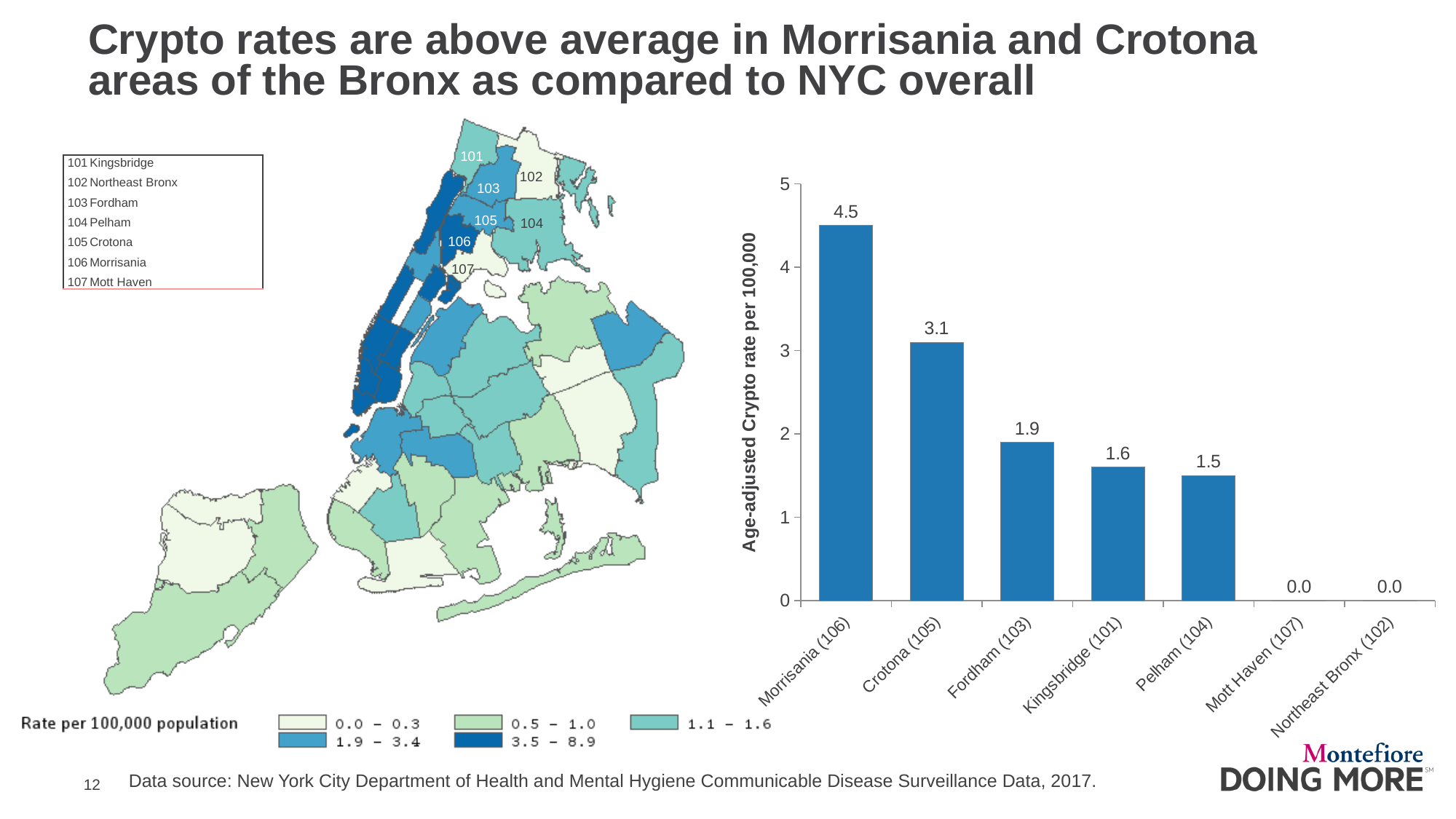
What is the age-adjusted Crypto rate per 100,000 for Pelham (104)? 1.5 What kind of chart is used to show the age-adjusted Crypto rates? Bar chart Which area has the highest age-adjusted Crypto rate in the bar chart? Morrisania (106) Do the values in the bar chart rise or fall from left to right? Fall How many areas are shown on the x axis of the bar chart? 7 What is the Crypto rate shown for Mott Haven (107)? 0.0 What is the age-adjusted Crypto rate per 100,000 for Morrisania (106)? 4.5 What is the label of the y axis of the bar chart? Age-adjusted Crypto rate per 100,000 What is the age-adjusted Crypto rate per 100,000 for Crotona (105)? 3.1 Which has a higher Crypto rate, Kingsbridge (101) or Pelham (104)? Kingsbridge (101) What is the age-adjusted Crypto rate per 100,000 for Fordham (103)? 1.9 What is the difference between the Crypto rates for Morrisania (106) and Crotona (105)? 1.4